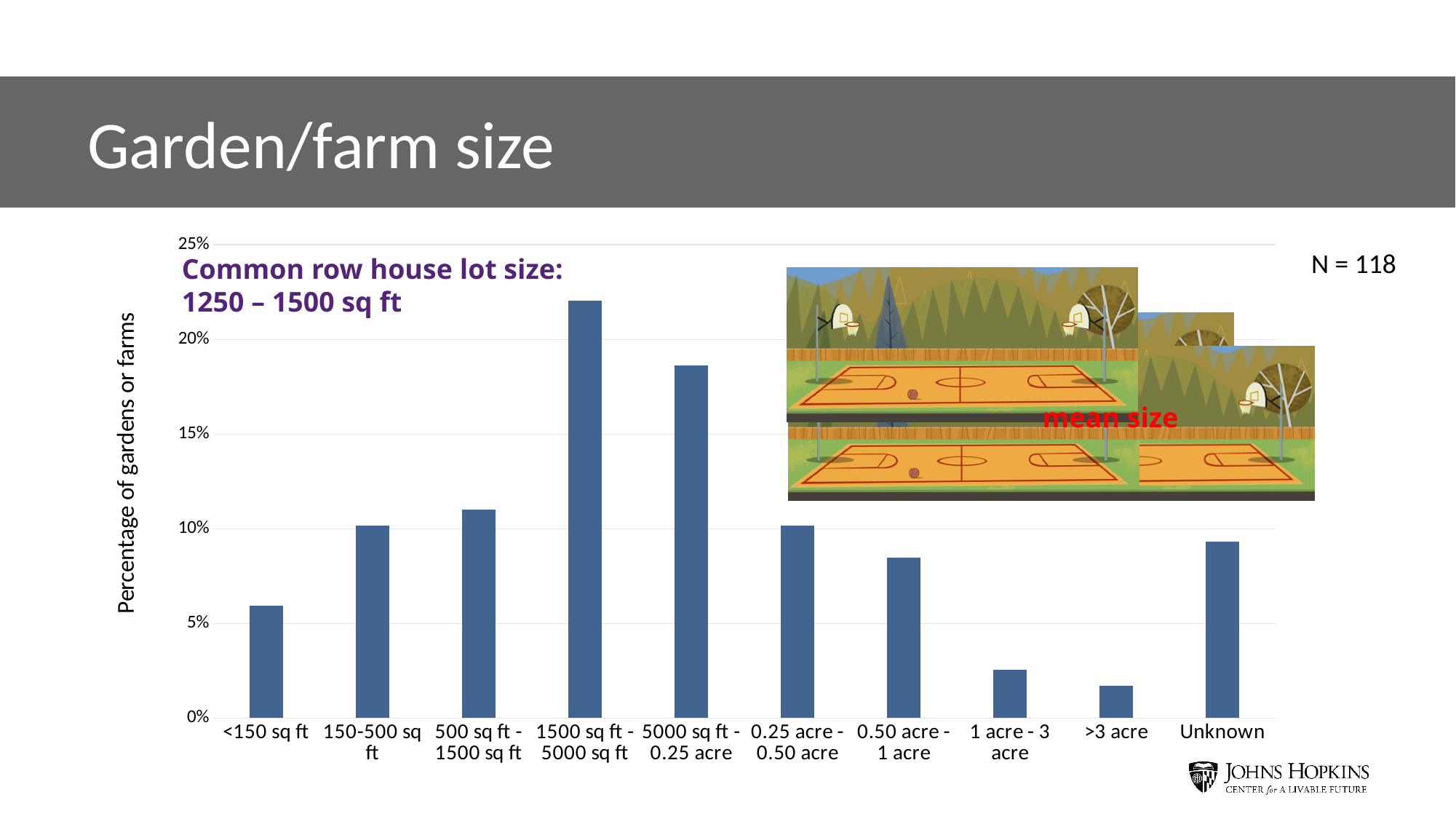
Which size category has the highest percentage of gardens or farms? 1500 sq ft - 5000 sq ft What is the label on the y axis of the chart? Percentage of gardens or farms How many size categories are shown on the x axis of the chart? 10 Which has a higher percentage of gardens or farms: Unknown or >3 acre? Unknown Is the value for 0.50 acre - 1 acre greater or less than 10%? less Is the value for 1 acre - 3 acre greater or less than 5%? less Is the value for 5000 sq ft - 0.25 acre greater or less than 15%? greater What kind of chart is shown on the slide? bar chart Which has a higher percentage of gardens or farms: 500 sq ft - 1500 sq ft or 0.50 acre - 1 acre? 500 sq ft - 1500 sq ft Which size category has the lowest percentage of gardens or farms? >3 acre